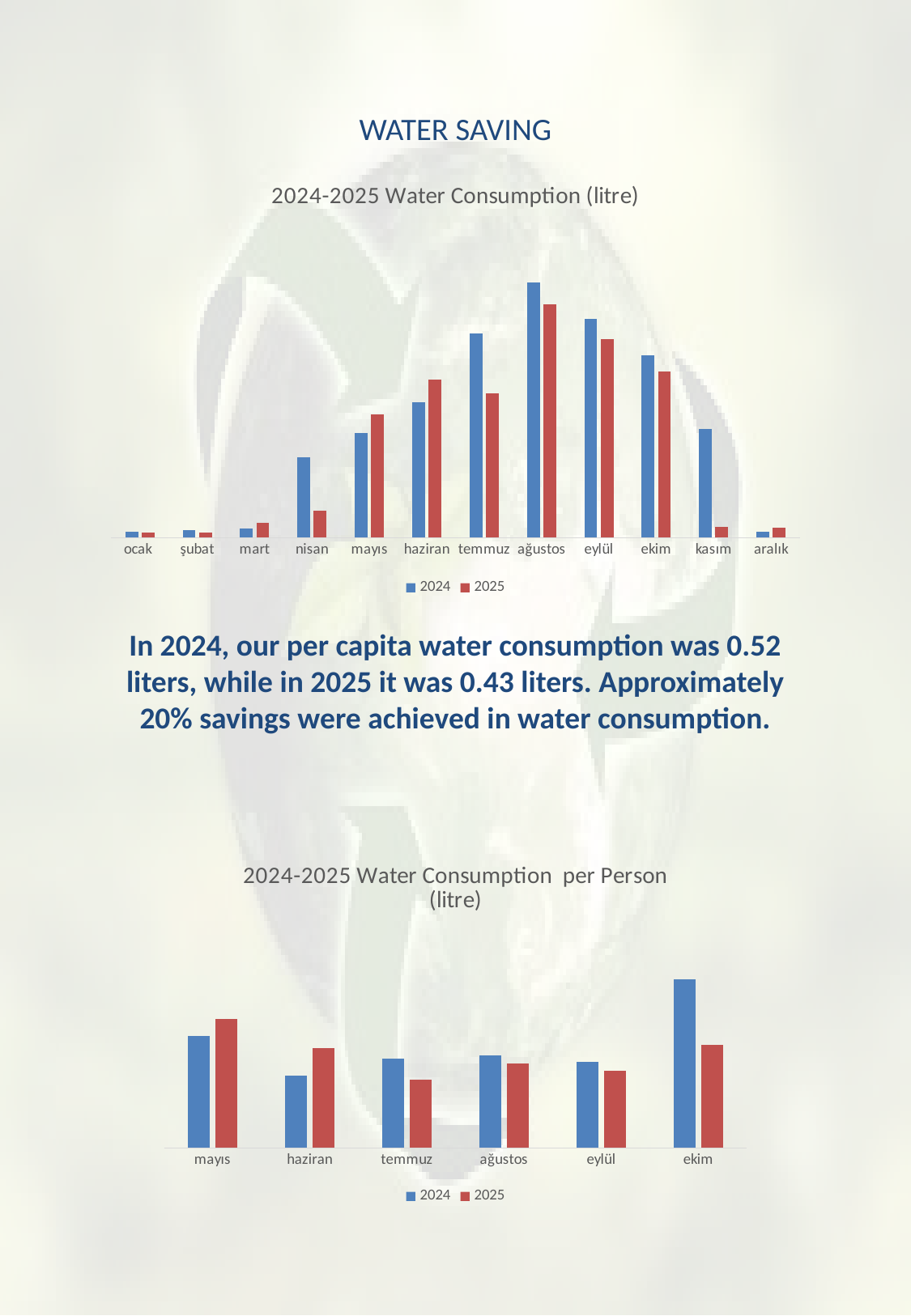
In the '2024-2025 Water Consumption per Person (litre)' chart, which month has the lowest value for 2025? temmuz In the '2024-2025 Water Consumption (litre)' chart, which is larger for haziran, the 2024 value or the 2025 value? 2025 In the '2024-2025 Water Consumption per Person (litre)' chart, which month has the highest value for 2024? ekim How many series does the legend of the '2024-2025 Water Consumption (litre)' chart list? 2 In the '2024-2025 Water Consumption (litre)' chart, which month has the highest value for 2025? ağustos In the '2024-2025 Water Consumption (litre)' chart, which is larger for kasım, the 2024 value or the 2025 value? 2024 In the '2024-2025 Water Consumption per Person (litre)' chart, which is larger for mayıs, the 2024 value or the 2025 value? 2025 How many months are shown on the x axis of the '2024-2025 Water Consumption (litre)' chart? 12 In the '2024-2025 Water Consumption (litre)' chart, which month has the highest value for 2024? ağustos What kind of chart is the '2024-2025 Water Consumption per Person (litre)' chart? Bar chart How many months are shown on the x axis of the '2024-2025 Water Consumption per Person (litre)' chart? 6